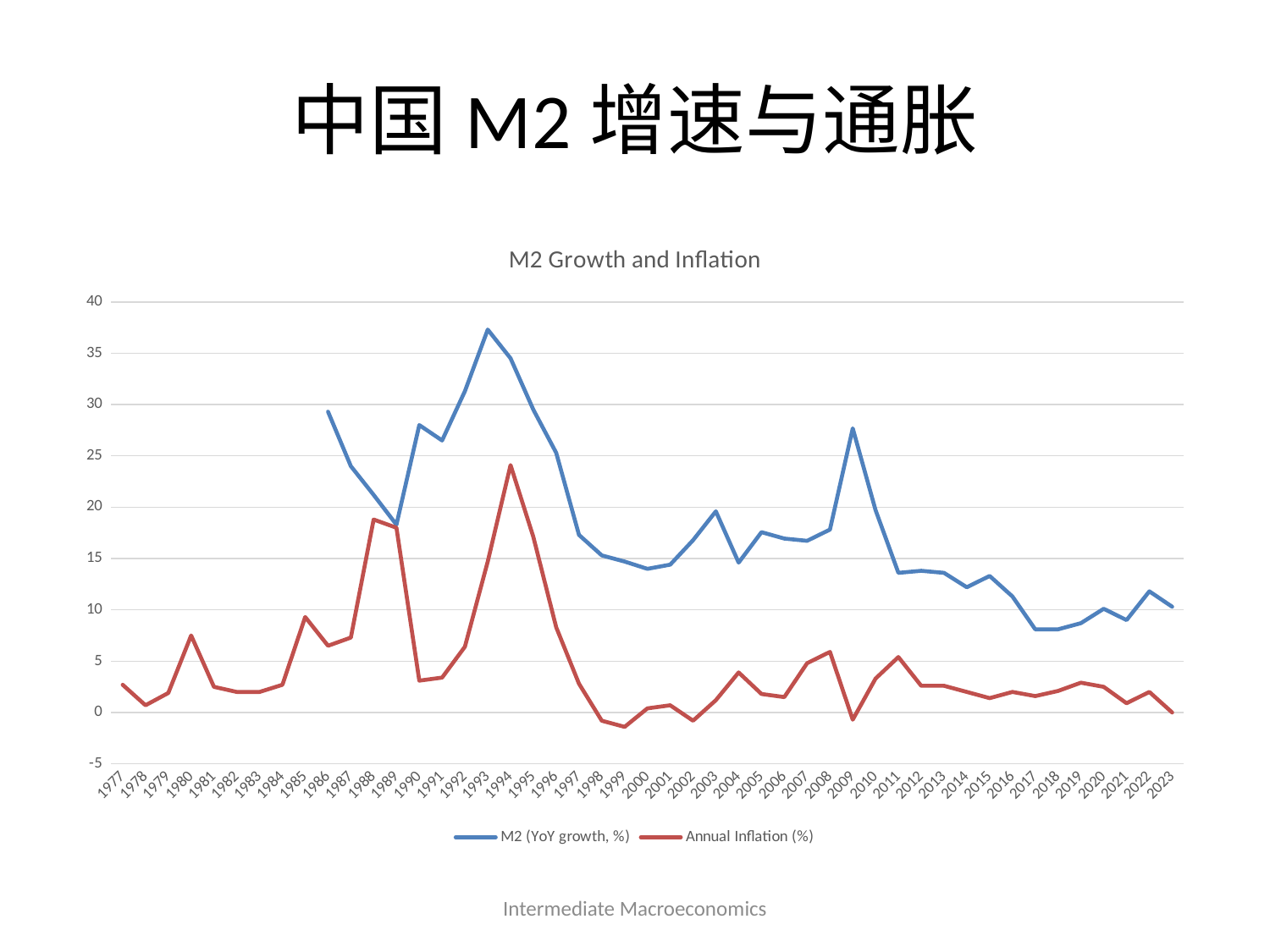
Is the M2 (YoY growth, %) value for 2023 greater or less than 15? less What is the title printed above the chart? M2 Growth and Inflation Is the Annual Inflation (%) value for 1994 greater or less than 20? greater In which year does the Annual Inflation (%) series reach its lowest value? 1999 In which year does the M2 (YoY growth, %) series reach its highest value? 1993 What kind of chart is shown on the slide? line chart Does the M2 (YoY growth, %) series rise or fall from 2009 to 2017? fall How many years are shown along the x axis? 47 In which year does the Annual Inflation (%) series reach its highest value? 1994 Which is larger: the Annual Inflation (%) value in 1988 or in 1985? 1988 How many series does the legend list? 2 Is the M2 (YoY growth, %) value for 1993 greater or less than 35? greater